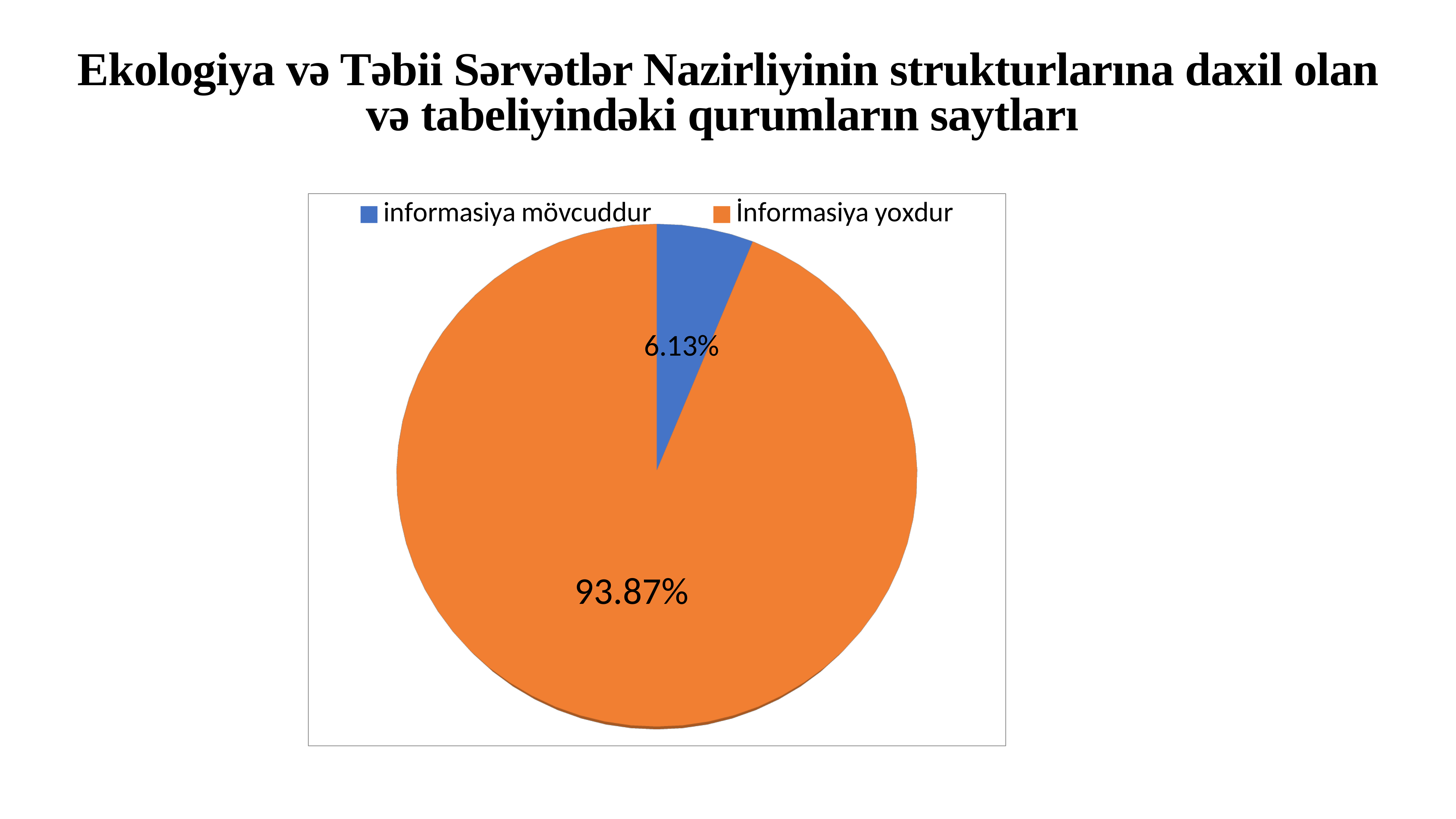
What share of the pie does "informasiya mövcuddur" represent? 6.13% What share of the pie does "İnformasiya yoxdur" represent? 93.87% Which slice is the largest? İnformasiya yoxdur What colour is the "informasiya mövcuddur" slice? blue What colour is the "İnformasiya yoxdur" slice? orange What kind of chart is shown on the slide? pie chart What is the difference in percentage points between the "İnformasiya yoxdur" slice and the "informasiya mövcuddur" slice? 87.74 How many entries does the legend list? 2 Which slice is the smallest? informasiya mövcuddur Which is larger: the "informasiya mövcuddur" slice or the "İnformasiya yoxdur" slice? İnformasiya yoxdur How many slices does the pie chart have? 2